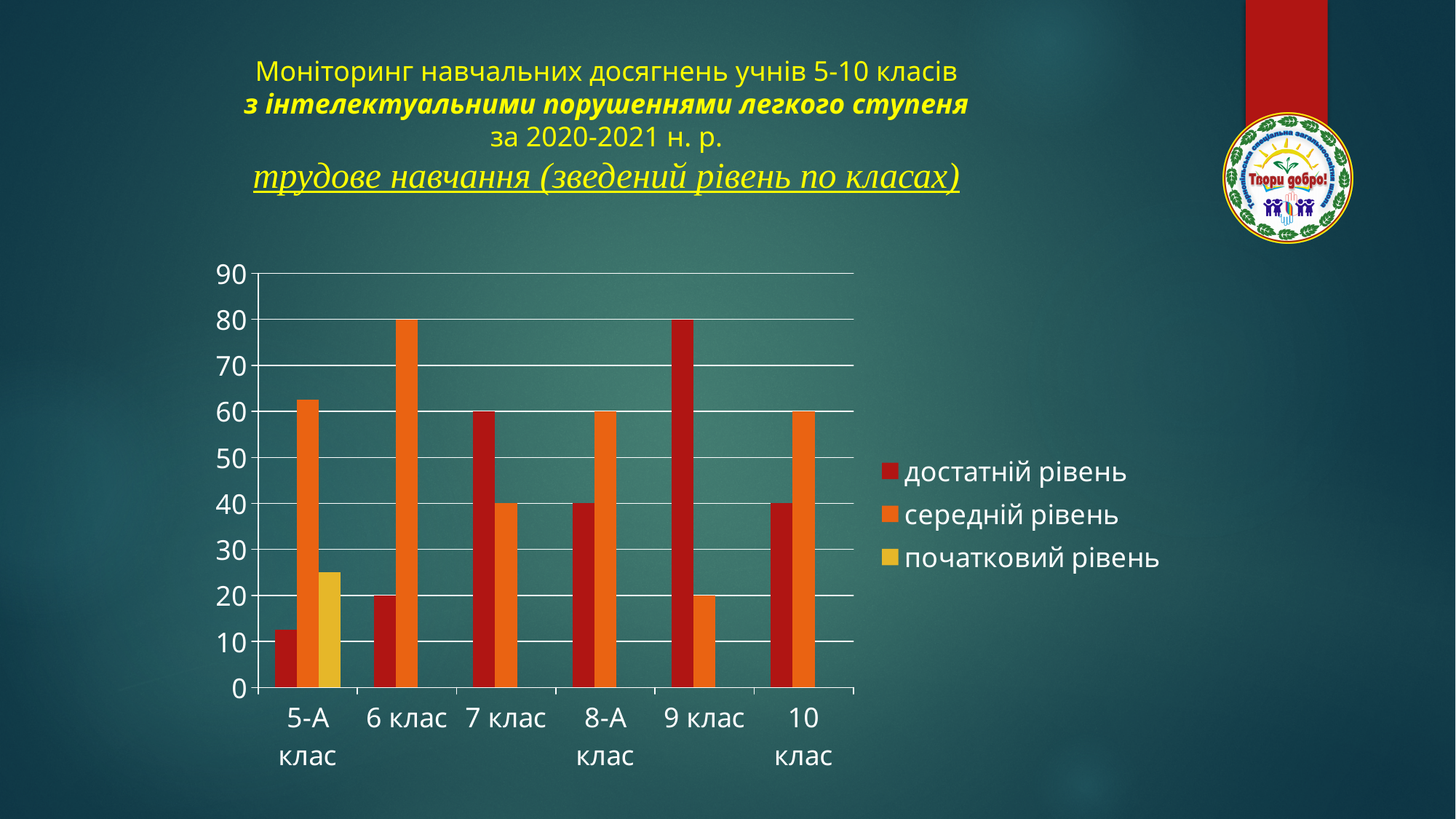
Which class has the lowest середній рівень? 9 клас What is the value of достатній рівень for 7 клас? 60 How many classes (categories) are shown on the x axis? 6 Which class has the highest достатній рівень? 9 клас What is the value of середній рівень for 6 клас? 80 How many series does the legend list? 3 What is the value of достатній рівень for 9 клас? 80 For 7 клас, which is larger: достатній рівень or середній рівень? достатній рівень What is the difference between достатній рівень and середній рівень for 9 клас? 60 What type of chart is shown on the slide? bar chart Is the value of достатній рівень for 5-А клас greater or less than 20? less Is the value of початковий рівень for 5-А клас greater or less than 20? greater